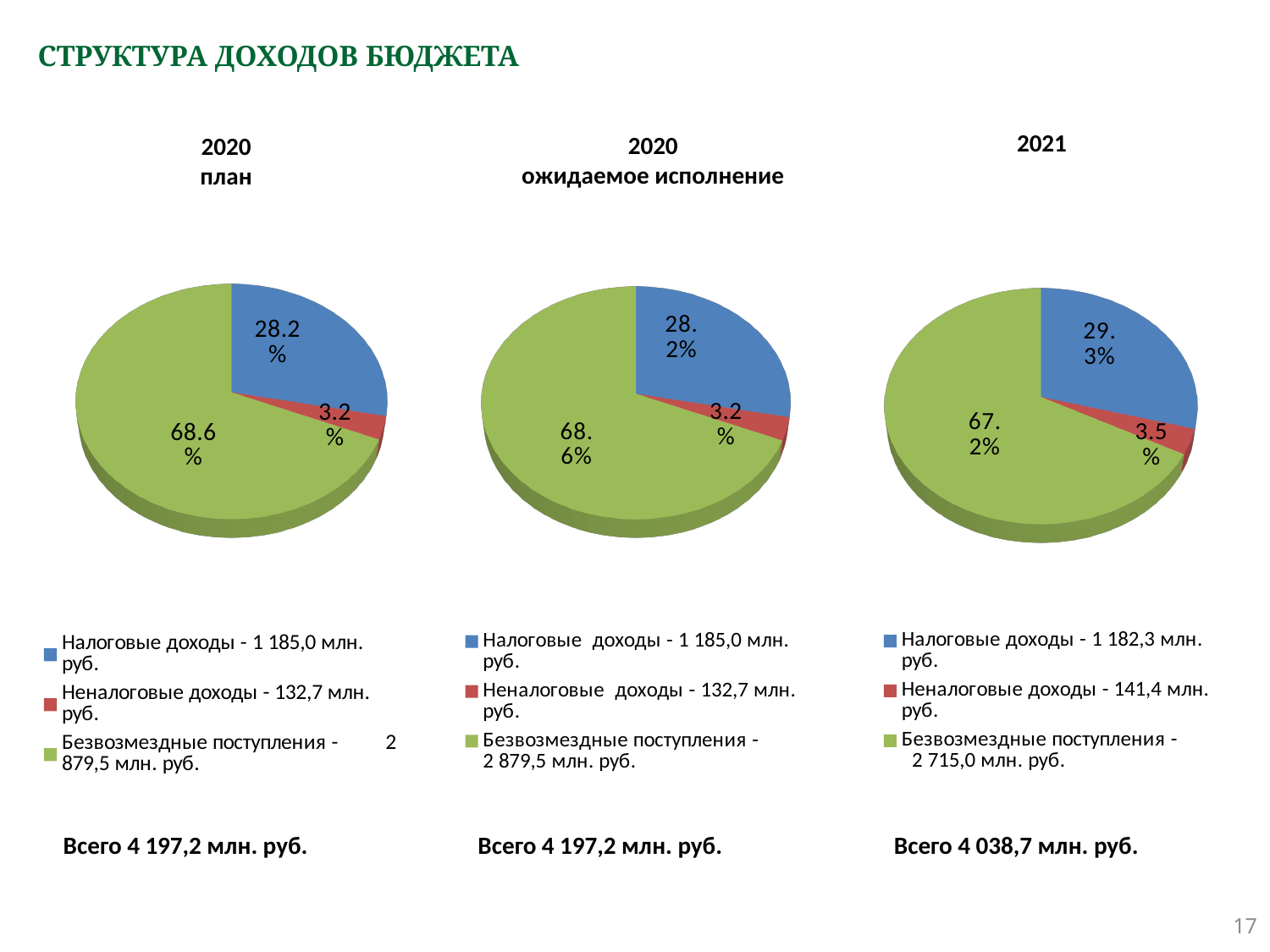
In the "2021" chart, which slice is larger: Налоговые доходы or Неналоговые доходы? Налоговые доходы In the "2021" chart, what share is shown for Налоговые доходы? 29.3% How many slices does the "2020 план" pie chart have? 3 How many pie charts are shown on the slide? 3 What kind of chart is the "2021" chart? pie chart In the "2021" chart, which category has the smallest slice? Неналоговые доходы In the "2021" chart, what is the difference in percentage points between the Безвозмездные поступления share and the Налоговые доходы share? 37.9 percentage points By how many percentage points is the Налоговые доходы share in the "2021" chart higher than in the "2020 план" chart? 1.1 percentage points In the "2020 ожидаемое исполнение" chart, which category has the largest slice? Безвозмездные поступления In the "2020 план" chart, what share is shown for Безвозмездные поступления? 68.6% In the legend of the "2021" chart, what amount is given for Безвозмездные поступления? 2 715,0 млн. руб. In the "2020 ожидаемое исполнение" chart, what share is shown for Неналоговые доходы? 3.2%